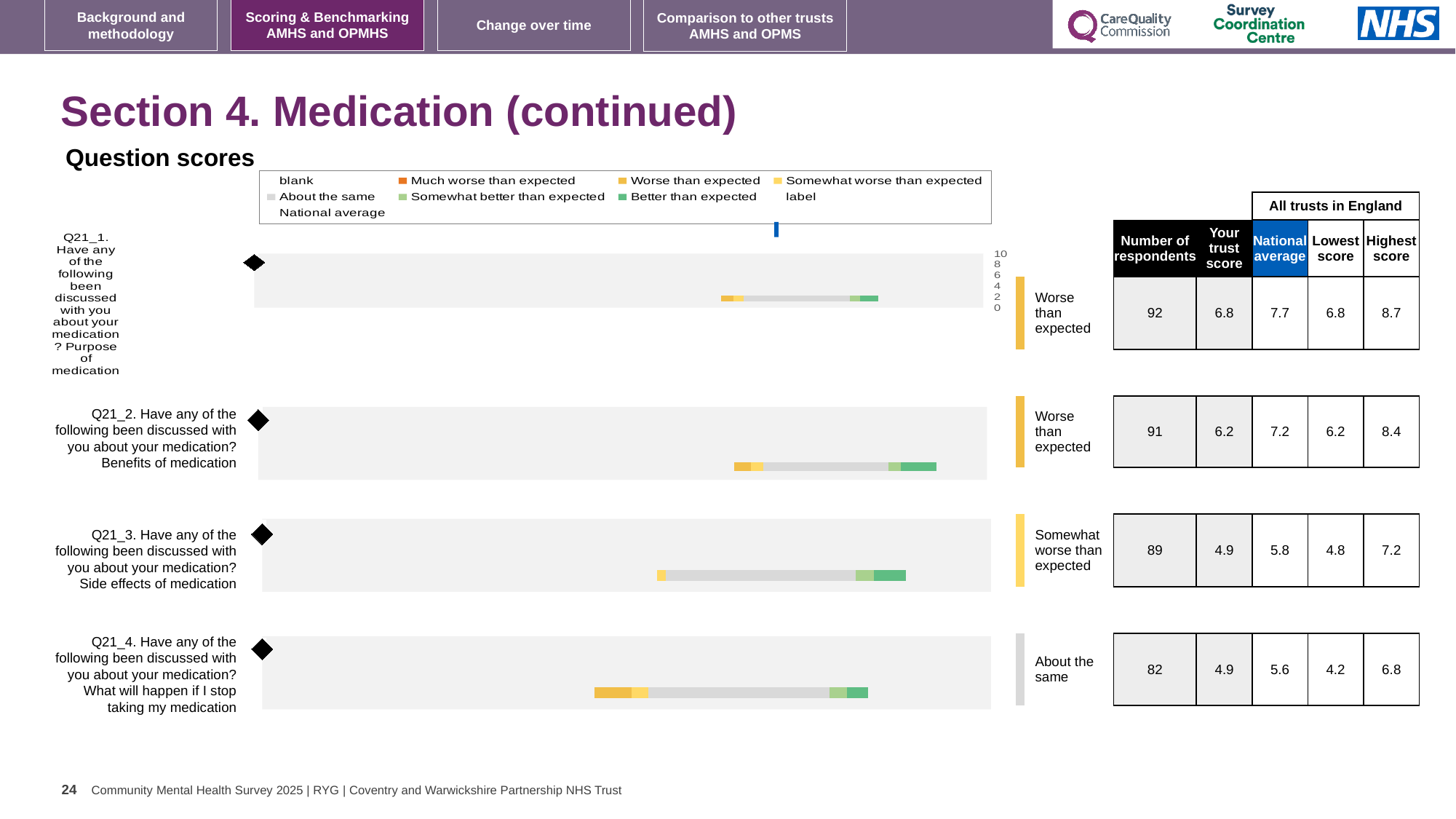
How many respondents answered Q21_3 (Side effects of medication)? 89 How many questions (Q21_1 to Q21_4) are plotted on the slide? 4 Which question has the highest number of respondents? Q21_1 Which question has the lowest national average? Q21_4 What benchmark category is shown for Q21_4? About the same What kind of chart is used for the question scores on this slide? bar chart What is the difference between the national average and the trust score for Q21_1? 0.9 What is the highest score among all trusts in England for Q21_4 (What will happen if I stop taking my medication)? 6.8 What is the national average for Q21_2 (Benefits of medication)? 7.2 What benchmark category is shown for Q21_3? Somewhat worse than expected For Q21_2, which is larger: the trust score or the national average? national average What is the 'Your trust score' for Q21_1 (Purpose of medication)? 6.8